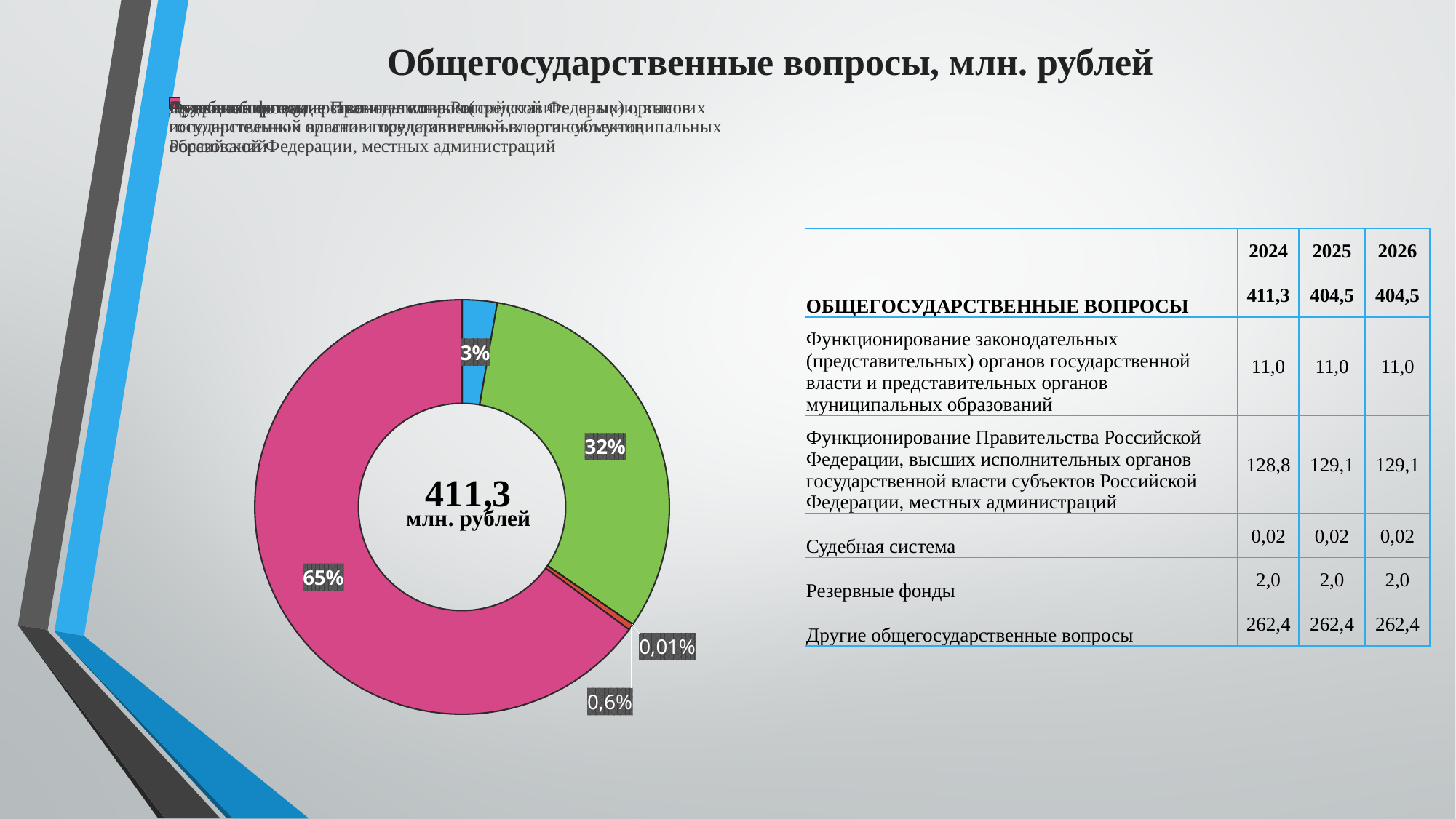
What kind of chart is shown on the slide? Doughnut (pie) chart Is the share of the green slice greater or less than 50%? less What is the largest share shown on the doughnut chart? 65% What share is labelled on the blue slice of the doughnut chart? 3% What share is labelled on the green slice of the doughnut chart? 32% Which slice is larger on the doughnut chart, the green one or the blue one? The green one What is the smallest share shown on the doughnut chart? 0,01% What colour is the largest slice of the doughnut chart? Pink (magenta) What is the title of the slide containing the doughnut chart? Общегосударственные вопросы, млн. рублей What value is printed in the centre of the doughnut chart? 411,3 млн. рублей How many slices does the doughnut chart have? 5 What is the difference in percentage points between the 65% slice and the 32% slice? 33 percentage points